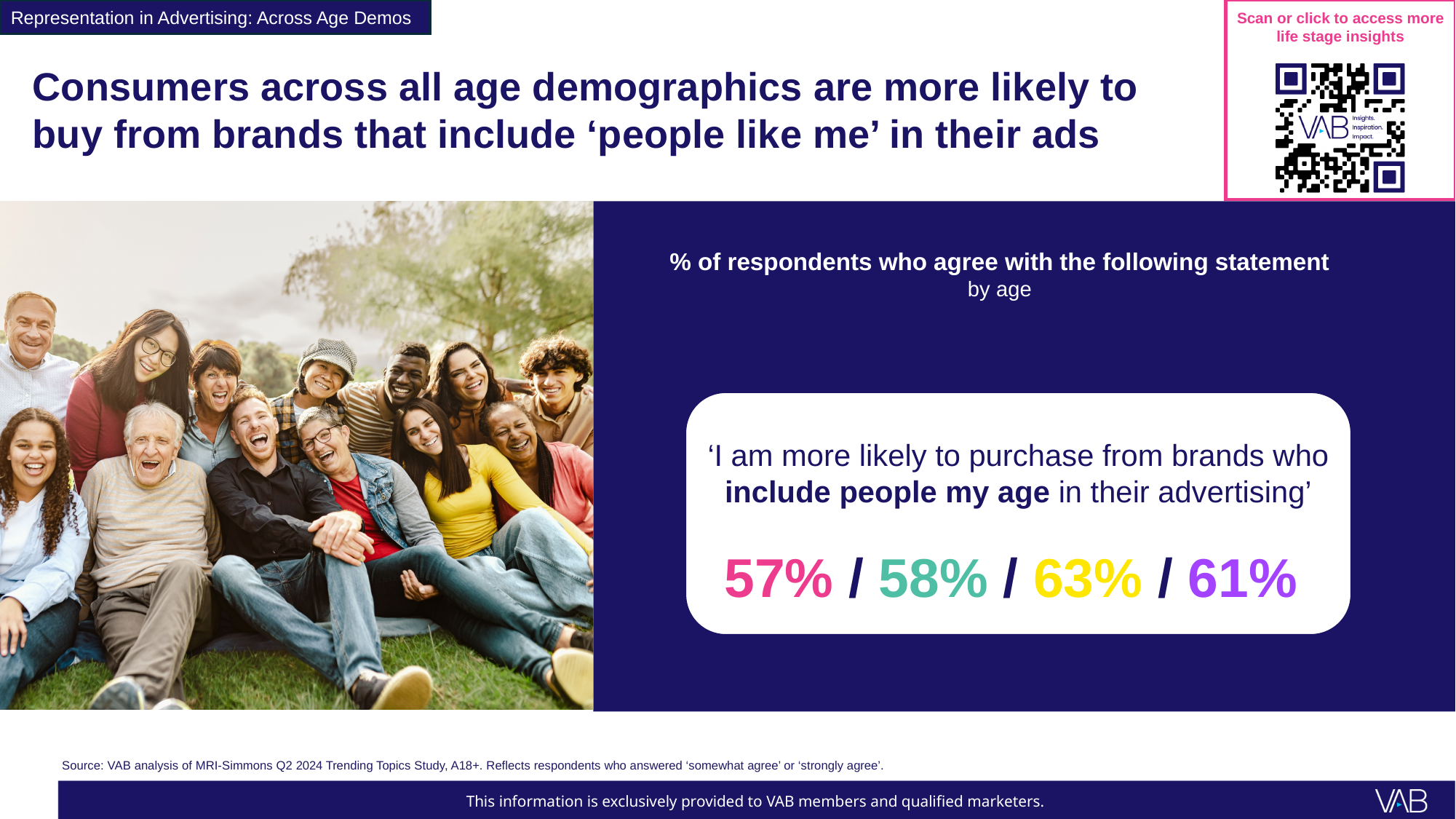
What is the difference between the highest and lowest percentages shown in the callout box? 6 percentage points What is the first (leftmost) percentage shown in the callout box? 57% Which is larger, the second percentage (58%) or the fourth percentage (61%) in the callout box? 61% What is the percentage shown in pink in the callout box? 57% What is the highest percentage shown in the callout box? 63% How many percentage values are shown in the callout box for the statement 'I am more likely to purchase from brands who include people my age in their advertising'? 4 Is the leftmost percentage in the callout box greater or less than 60%? less What is the percentage shown in yellow in the callout box? 63% What is the lowest percentage shown in the callout box? 57% What is the difference between the third percentage (63%) and the second percentage (58%) in the callout box? 5 percentage points What is the last (rightmost) percentage shown in the callout box? 61%